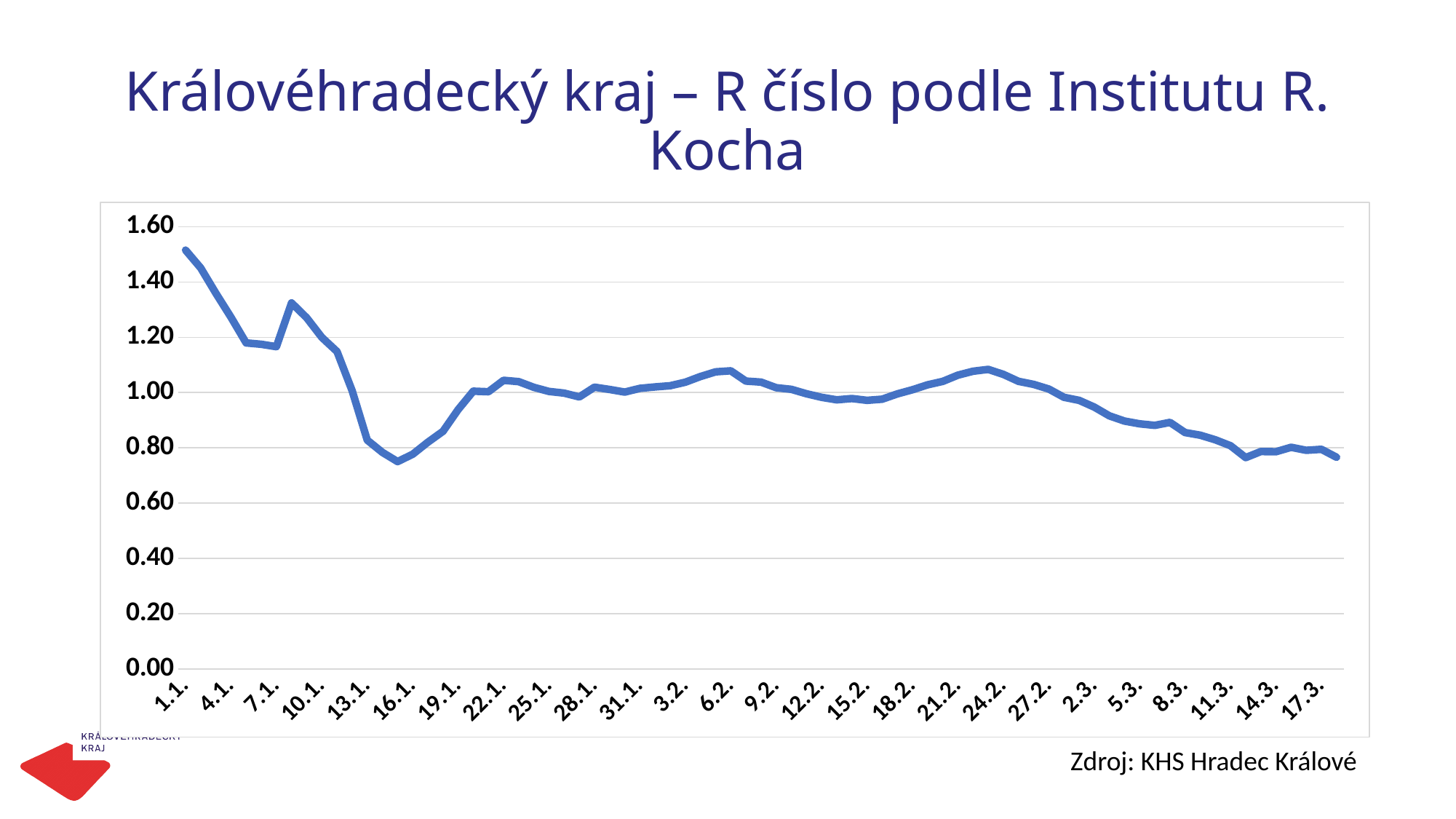
Is the value for 10.1. greater or less than 1.00? greater Which has the larger value, 1.1. or 17.3.? 1.1. Which has the larger value, 10.1. or 16.1.? 10.1. Is the value for 16.1. greater or less than 0.80? less Is the value for 8.3. greater or less than 1.00? less Which date on the x axis has the highest R value? 1.1. What source is cited below the chart? KHS Hradec Králové Overall, does the R value rise or fall from 1.1. to 17.3.? fall What kind of chart is shown on the slide? line chart What is the title of the chart on the slide? Královéhradecký kraj – R číslo podle Institutu R. Kocha